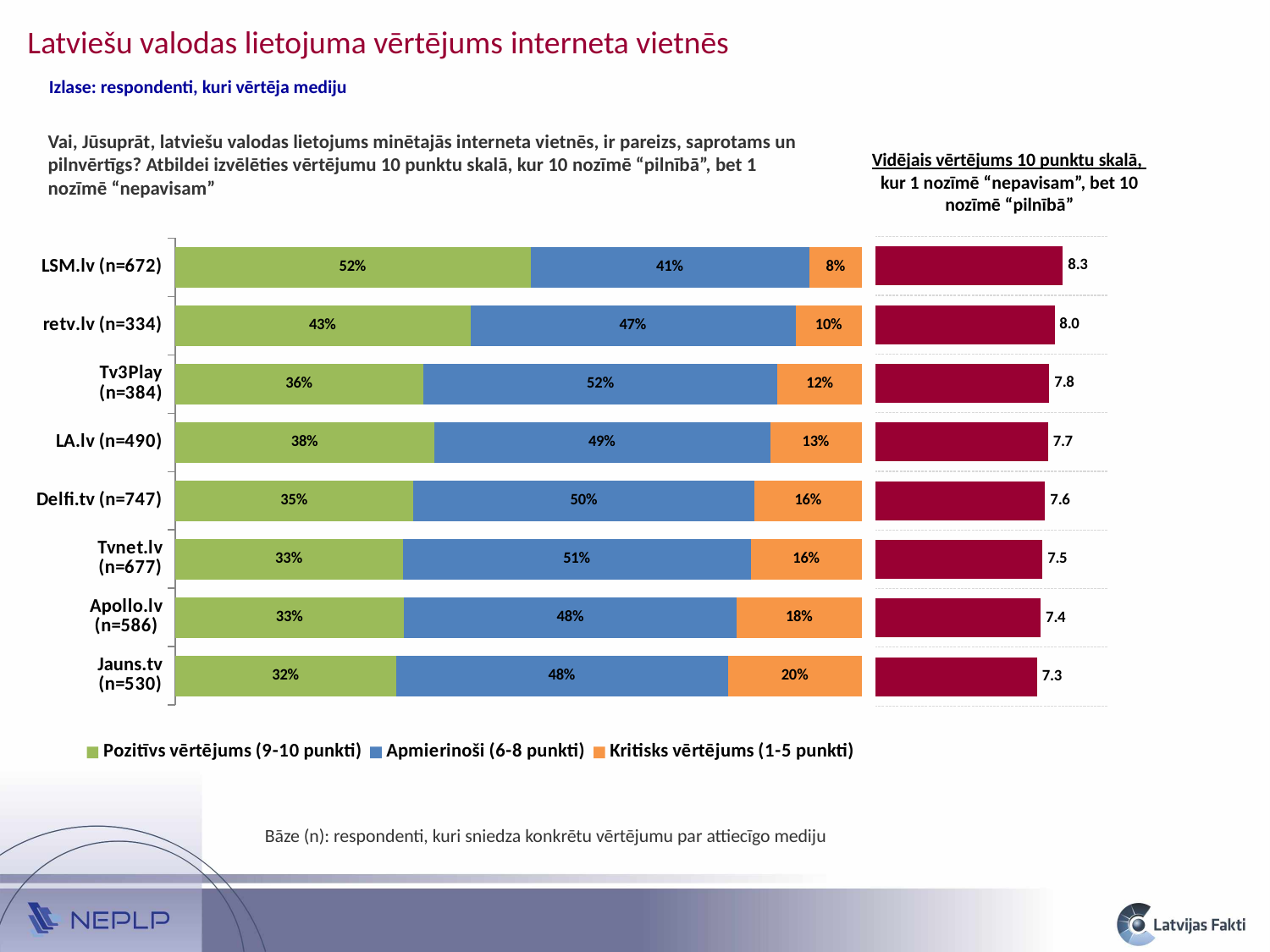
In the stacked bar chart on the left, what percentage of LSM.lv respondents gave a positive rating (9-10 points)? 52% In the stacked bar chart on the left, what is the difference between the satisfactory (6-8 points) share for Tv3Play and for LSM.lv? 11 percentage points How many internet sites are listed as categories in the stacked bar chart on the left? 8 What kind of chart is the chart on the left? Stacked bar chart In the stacked bar chart on the left, which site has the lowest positive rating (9-10 points) share? Jauns.tv In the right-hand chart of average scores, what is the difference between the average score for LSM.lv and for Jauns.tv? 1.0 In the stacked bar chart on the left, what is the critical rating (1-5 points) share for Jauns.tv? 20% In the stacked bar chart on the left, which has a larger critical rating (1-5 points) share: Apollo.lv or LA.lv? Apollo.lv In the right-hand chart of average scores, which site has the highest average score? LSM.lv In the right-hand chart of average scores, do the values rise or fall going from LSM.lv at the top to Jauns.tv at the bottom? Fall In the right-hand chart of average scores (Vidējais vērtējums 10 punktu skalā), what is the average score for Delfi.tv? 7.6 How many series does the legend of the stacked bar chart on the left list? 3